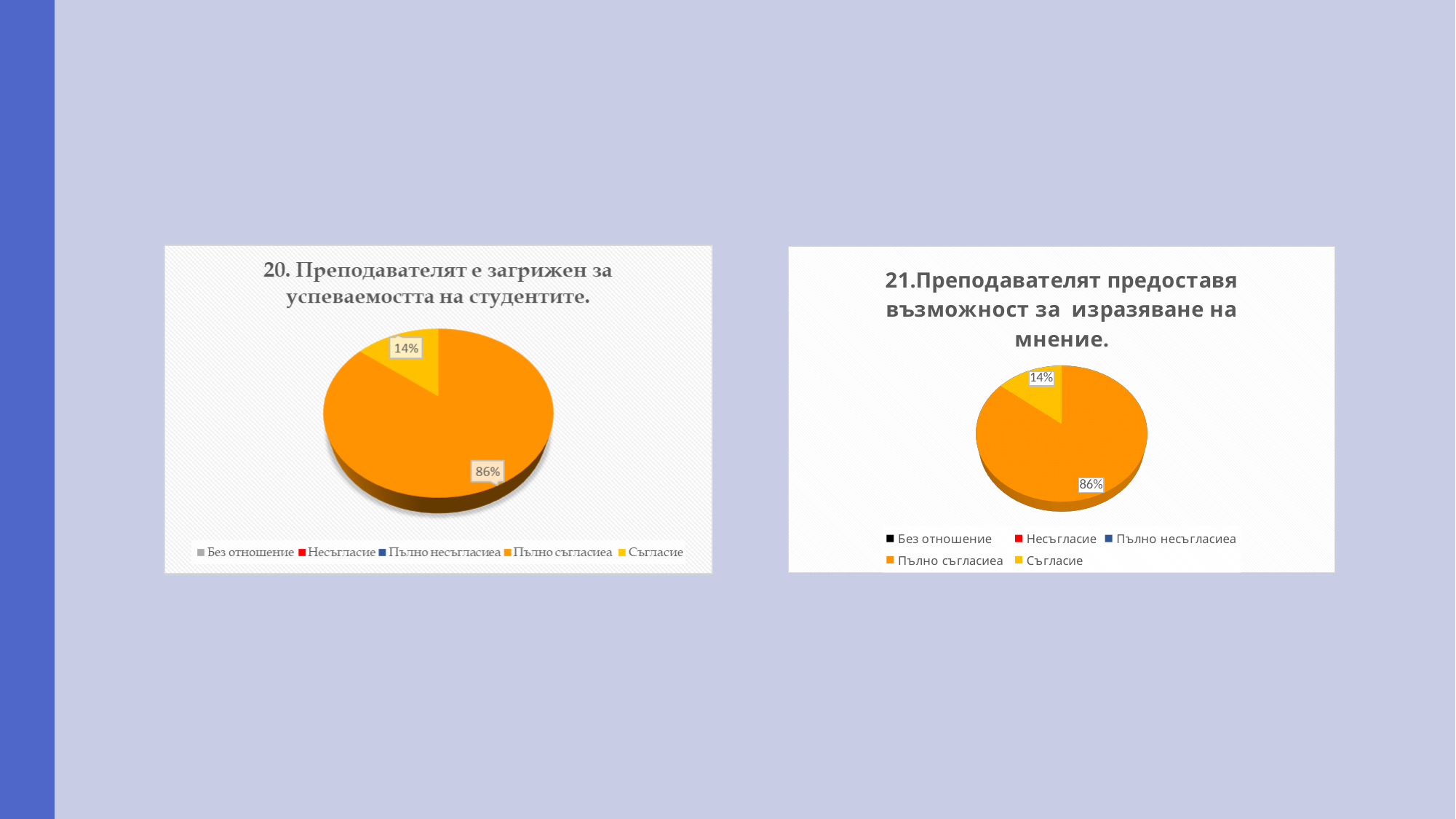
In the right chart (question 21), which slice is larger, 'Пълно съгласиеа' or 'Съгласие'? Пълно съгласиеа In the right chart (question 21), what share of the pie is labelled for the 'Съгласие' slice? 14% In the left chart (question 20), which category has the largest slice? Пълно съгласиеа How many slices with data labels are visible in the left chart (question 20)? 2 In the left chart (question 20), what is the difference in percentage points between the 'Пълно съгласиеа' and 'Съгласие' slices? 72 In the right chart (question 21), which category has the largest slice? Пълно съгласиеа How many entries does the legend of the right chart (question 21) list? 5 What is the title of the right chart? 21.Преподавателят предоставя възможност за изразяване на мнение. In the left chart (question 20), what share of the pie is labelled for the 'Пълно съгласиеа' slice? 86% What kind of chart is the left chart (question 20)? Pie chart In the right chart (question 21), what share of the pie is labelled for the 'Пълно съгласиеа' slice? 86%